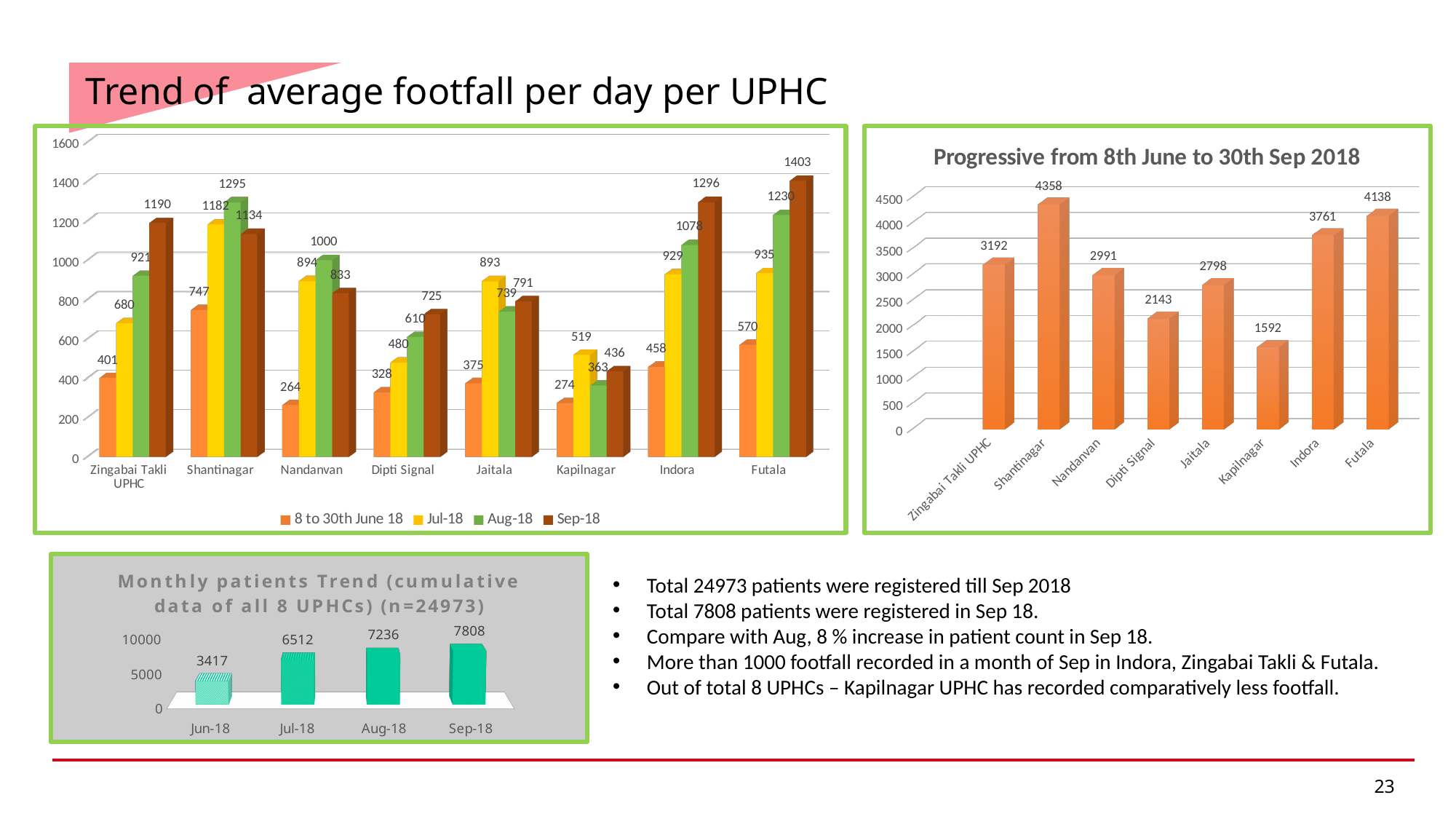
In the top-left chart, which UPHC has the lowest value for 8 to 30th June 18? Nandanvan In the top-left chart, which is larger for Shantinagar: the Aug-18 value or the Sep-18 value? Aug-18 In the top-left chart, how many series does the legend list? 4 In the 'Monthly patients Trend' chart, do the values rise or fall from Jun-18 to Sep-18? rise In the top-left chart, what is the Sep-18 value for Futala? 1403 In the 'Monthly patients Trend' chart, what is the value for Jul-18? 6512 In the top-left chart, what is the Jul-18 value for Nandanvan? 894 In the 'Progressive from 8th June to 30th Sep 2018' chart, what is the difference between Futala and Indora? 377 In the 'Progressive from 8th June to 30th Sep 2018' chart, what is the value for Kapilnagar? 1592 In the top-left chart, what is the difference between the Sep-18 and Aug-18 values for Indora? 218 In the 'Progressive from 8th June to 30th Sep 2018' chart, how many UPHCs are shown? 8 In the 'Progressive from 8th June to 30th Sep 2018' chart, which UPHC has the highest value? Shantinagar